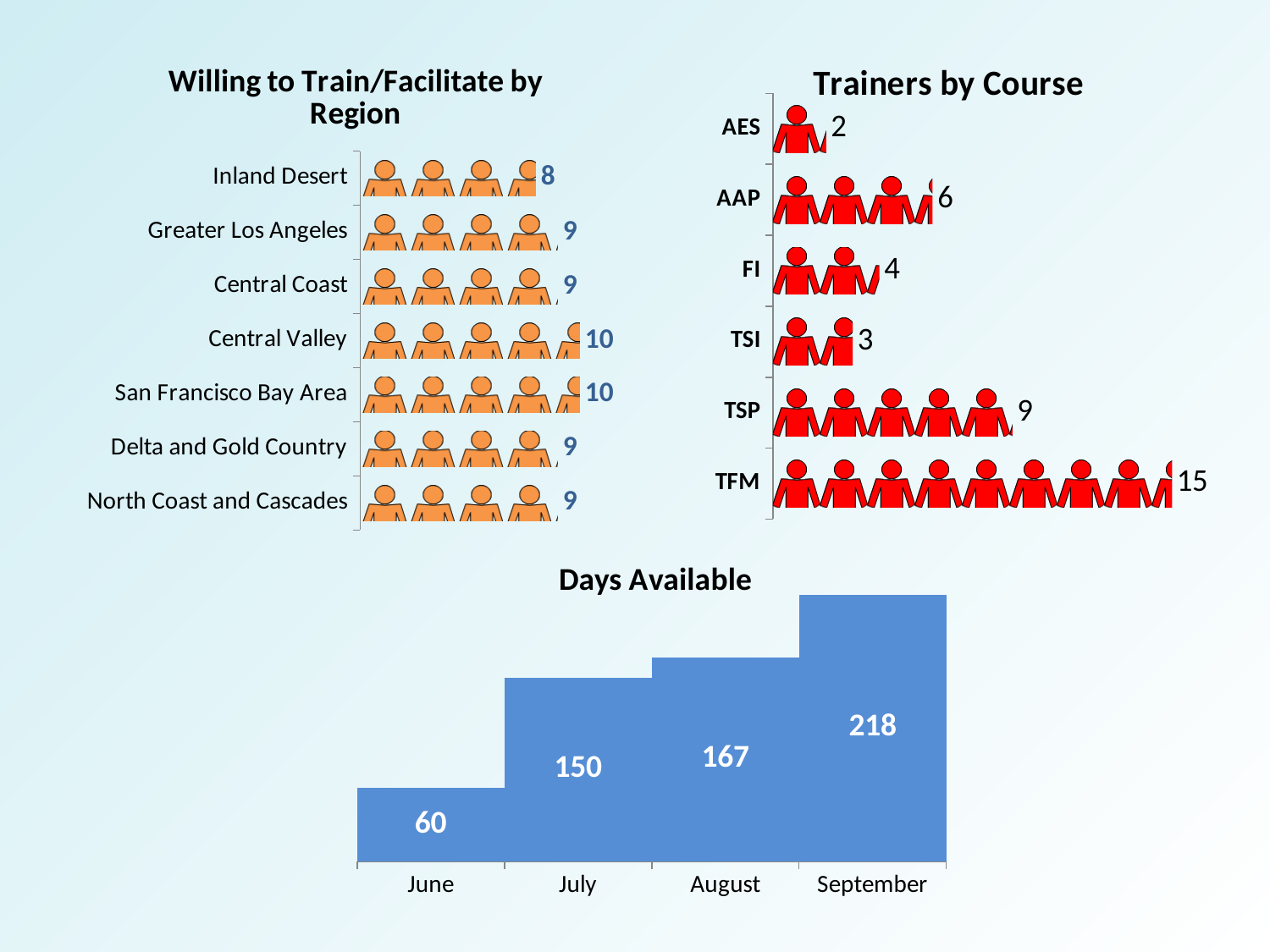
In the 'Trainers by Course' chart, what is the difference between the number of trainers for TSP and FI? 5 In the 'Days Available' chart, what is the difference between September and June? 158 How many regions are shown in the 'Willing to Train/Facilitate by Region' chart? 7 In the 'Willing to Train/Facilitate by Region' chart, what is the value for Inland Desert? 8 In the 'Trainers by Course' chart, how many trainers are there for TFM? 15 In the 'Trainers by Course' chart, which has more trainers, AAP or TSI? AAP In the 'Willing to Train/Facilitate by Region' chart, which regions have the highest value? Central Valley and San Francisco Bay Area How many courses are listed in the 'Trainers by Course' chart? 6 In the 'Days Available' chart, what is the value for August? 167 In the 'Willing to Train/Facilitate by Region' chart, which region has the lowest value? Inland Desert In the 'Days Available' chart, do the values rise or fall from June to September? rise In the 'Trainers by Course' chart, which course has the fewest trainers? AES